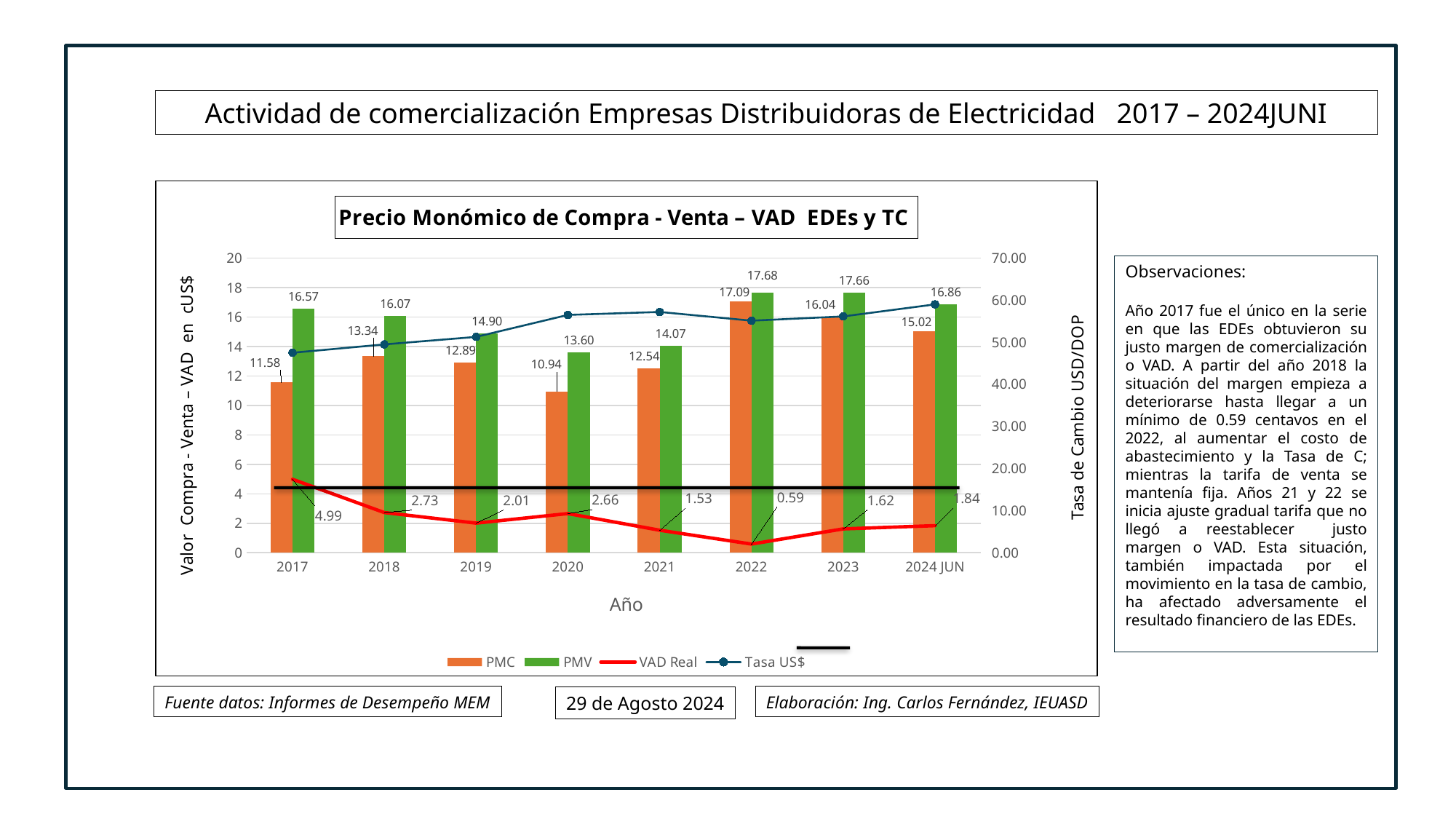
Does the VAD Real series rise or fall from 2017 to 2022? fall What is the VAD Real value for 2022? 0.59 What is the difference between PMV and PMC in 2017? 4.99 In which year is the PMC value highest? 2022 Is the Tasa US$ value for 2020 greater or less than 50.00? greater What is the PMC value for 2020? 10.94 How many years are shown on the x axis? 8 In which year is the PMV value lowest? 2020 How many series does the legend list? 4 In which year is the VAD Real value lowest? 2022 What is the PMV value for 2022? 17.68 Which year has the larger PMC value, 2018 or 2019? 2018